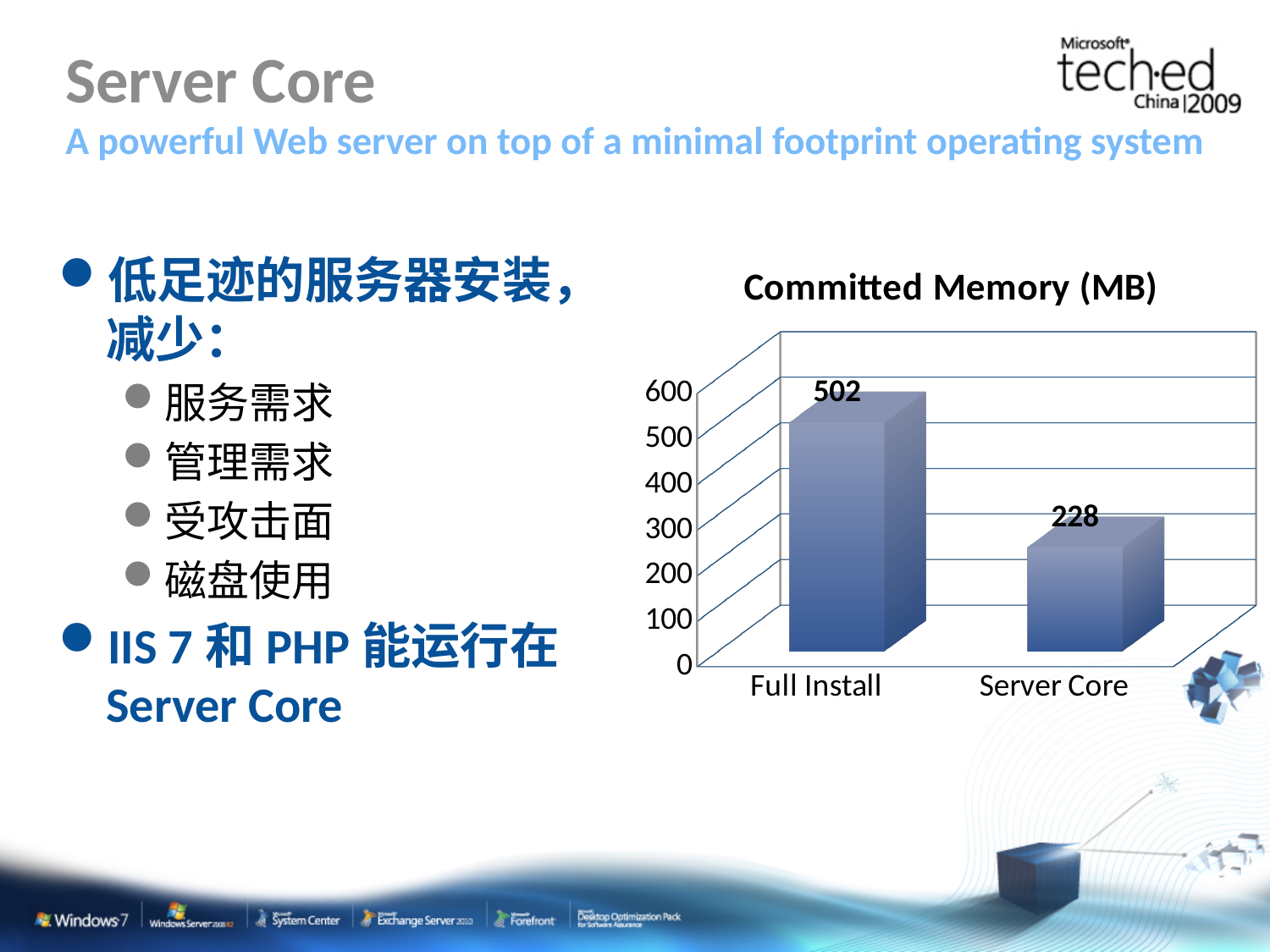
What is the title of the chart? Committed Memory (MB) Which has a larger committed memory value, Full Install or Server Core? Full Install What is the difference in committed memory between Full Install and Server Core? 274 How many categories are shown in the chart? 2 What is the highest value shown on the chart's vertical axis? 600 What is the committed memory value for Server Core? 228 Which category has the lowest committed memory? Server Core Is the value for Full Install greater or less than 400? greater What is the committed memory value for Full Install? 502 What kind of chart is shown on the slide? bar chart Is the value for Server Core greater or less than 300? less Which category has the highest committed memory? Full Install